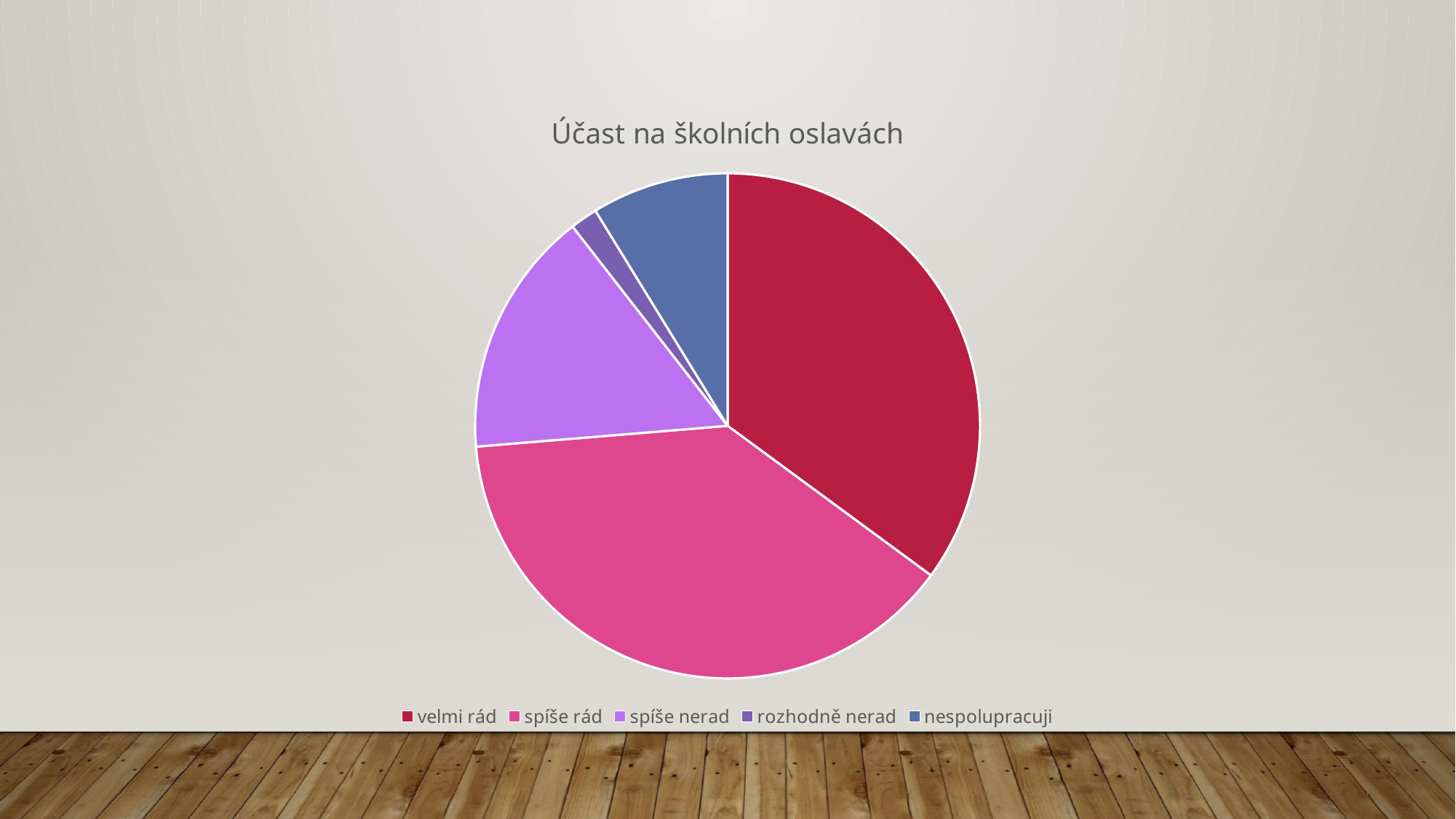
Which slice is larger: nespolupracuji or rozhodně nerad? nespolupracuji Which legend entry is shown in dark red? velmi rád Which slice is larger: velmi rád or spíše nerad? velmi rád Which slice is larger: spíše nerad or nespolupracuji? spíše nerad What is the title of the chart? Účast na školních oslavách How many categories (slices) does the pie chart have? 5 How many entries does the legend list? 5 Which category has the smallest slice of the pie? rozhodně nerad What kind of chart is shown on the slide? pie chart